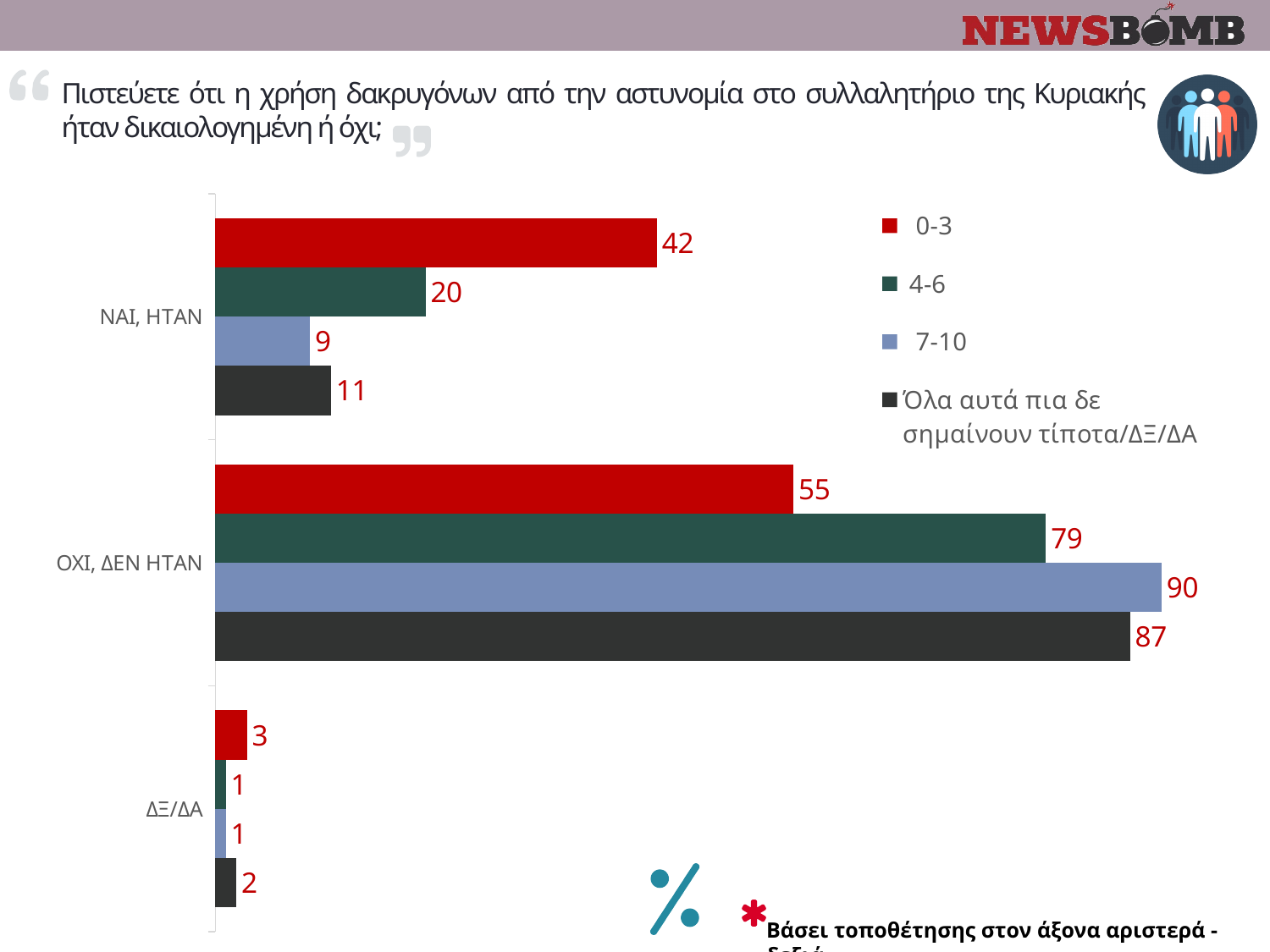
What kind of chart is shown on the slide? Bar chart How many series does the legend list? 4 What is the value for the 7-10 series in the ΟΧΙ, ΔΕΝ ΗΤΑΝ category? 90 Which colour represents the 0-3 series in the legend? Red Which series has the lowest value in the ΝΑΙ, ΗΤΑΝ category? 7-10 Which series has the highest value in the ΟΧΙ, ΔΕΝ ΗΤΑΝ category? 7-10 What is the difference between the 7-10 value and the 0-3 value in the ΟΧΙ, ΔΕΝ ΗΤΑΝ category? 35 What is the value for the 4-6 series in the ΔΞ/ΔΑ category? 1 Which is larger in the ΟΧΙ, ΔΕΝ ΗΤΑΝ category: the 4-6 value or the Όλα αυτά πια δε σημαίνουν τίποτα/ΔΞ/ΔΑ value? Όλα αυτά πια δε σημαίνουν τίποτα/ΔΞ/ΔΑ What is the difference between the 0-3 and 4-6 values in the ΝΑΙ, ΗΤΑΝ category? 22 What is the value for the 0-3 series in the ΝΑΙ, ΗΤΑΝ category? 42 How many answer categories are shown on the chart? 3